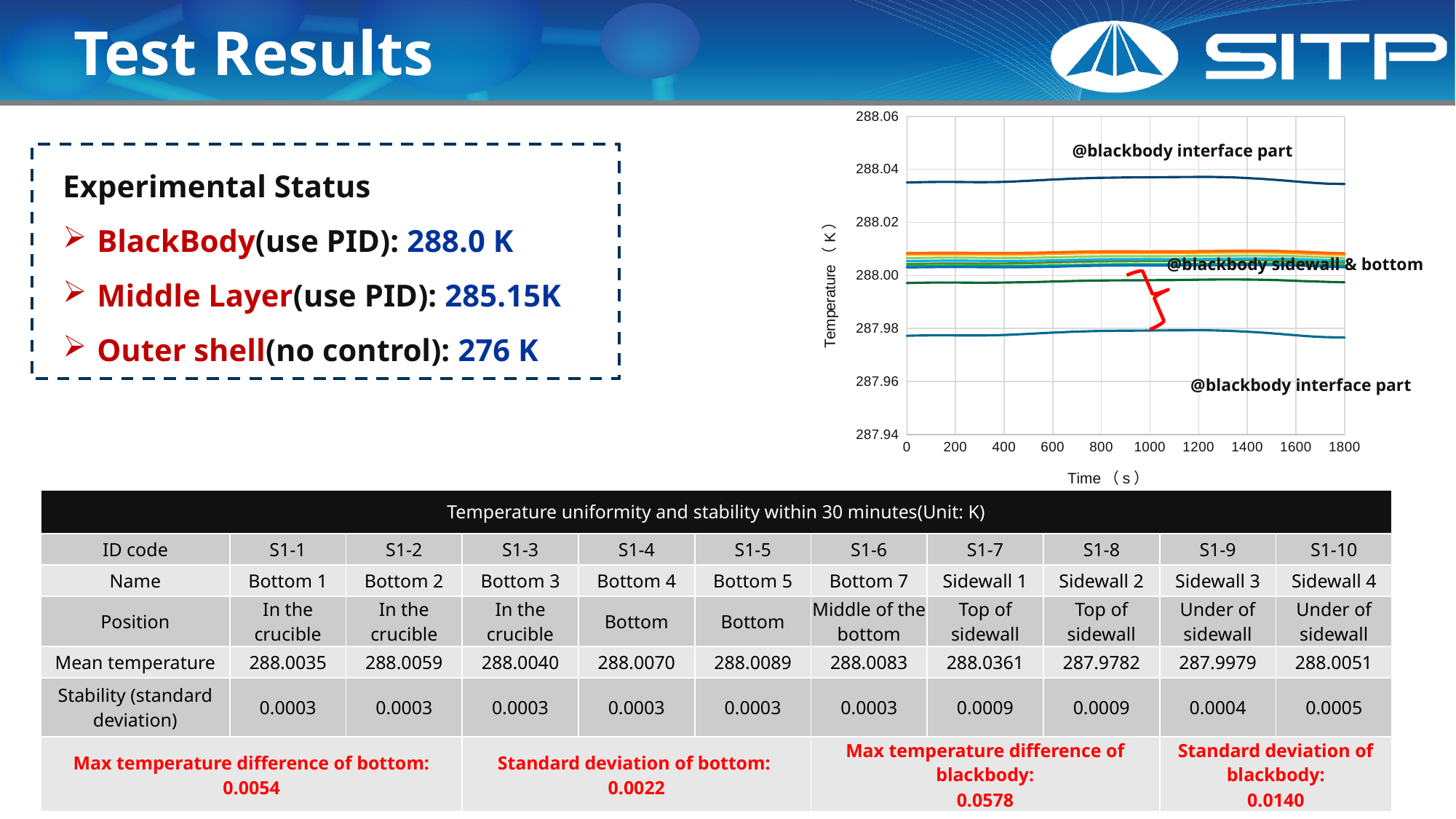
Is the temperature of the lowest line (labelled @blackbody interface part) greater or less than 288.00? less What is the label of the x axis of the chart? Time (s) Is the temperature of the lowest line on the chart greater or less than 287.96? greater What is the highest tick value on the y axis of the chart? 288.06 What is the label of the y axis of the chart? Temperature (K) Are the lines labelled @blackbody sidewall & bottom above or below 288.02? below What is the lowest tick value on the y axis of the chart? 287.94 Do the temperature lines rise, fall, or stay roughly flat over the 1800 s shown? stay roughly flat Which line is higher on the chart: the upper @blackbody interface part line or the @blackbody sidewall & bottom cluster? the upper @blackbody interface part line What kind of chart is shown on the slide? line chart What is the maximum value shown on the x axis of the chart? 1800